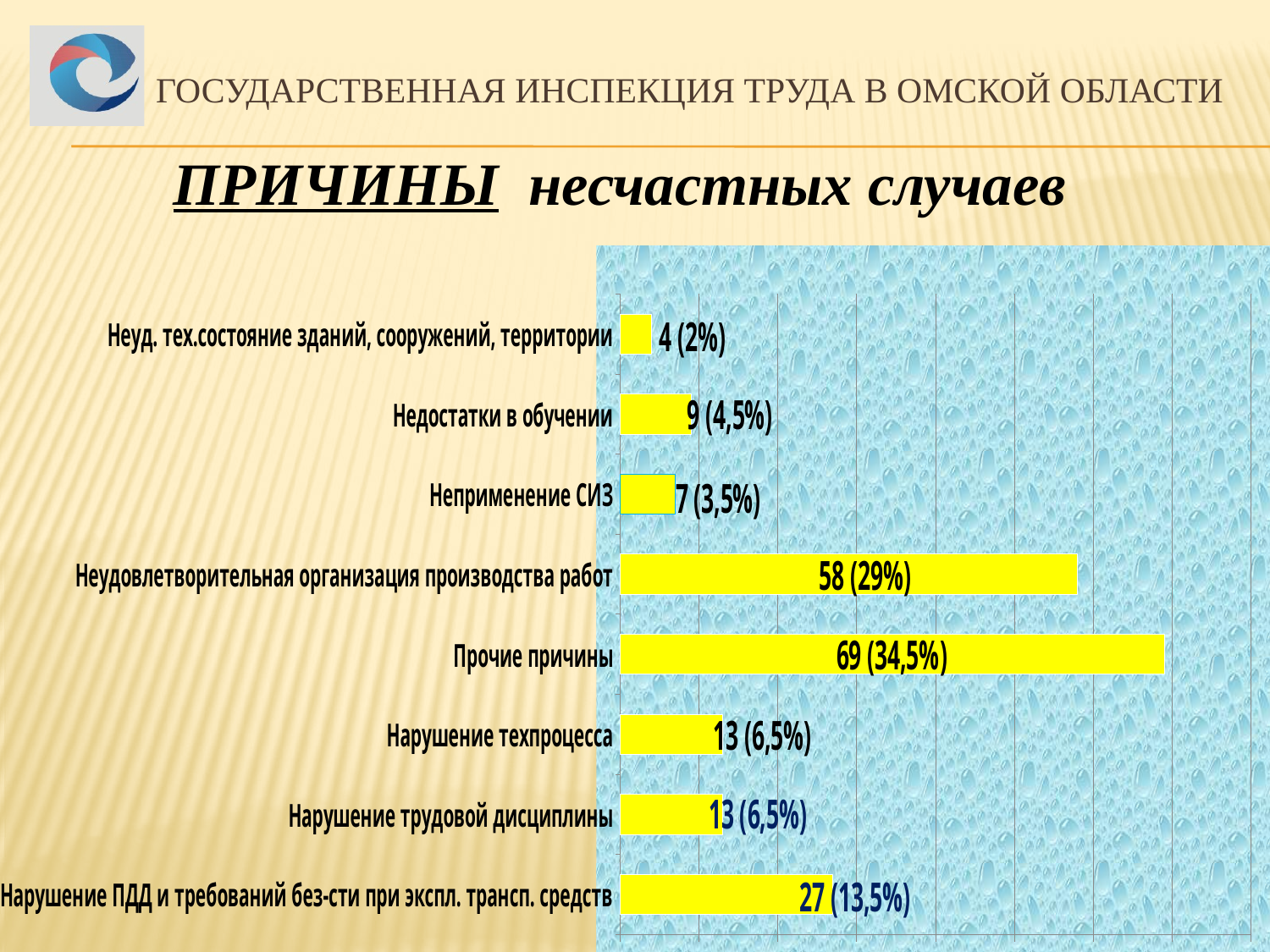
How many categories are shown in the chart? 8 Which category has the highest value? Прочие причины What is the difference in count between "Прочие причины" and "Неудовлетворительная организация производства работ"? 11 What is the data label for "Прочие причины"? 69 (34,5%) What is the difference in count between "Недостатки в обучении" and "Неприменение СИЗ"? 2 What type of chart is shown on the slide? Bar chart Which category has the lowest value? Неуд. тех.состояние зданий, сооружений, территории What is the data label for "Неприменение СИЗ"? 7 (3,5%) Which is larger: "Нарушение ПДД и требований без-сти при экспл. трансп. средств" or "Нарушение техпроцесса"? Нарушение ПДД и требований без-сти при экспл. трансп. средств What is the data label for "Неудовлетворительная организация производства работ"? 58 (29%) What is the title of the slide above the chart? ПРИЧИНЫ несчастных случаев What is the data label for "Нарушение ПДД и требований без-сти при экспл. трансп. средств"? 27 (13,5%)